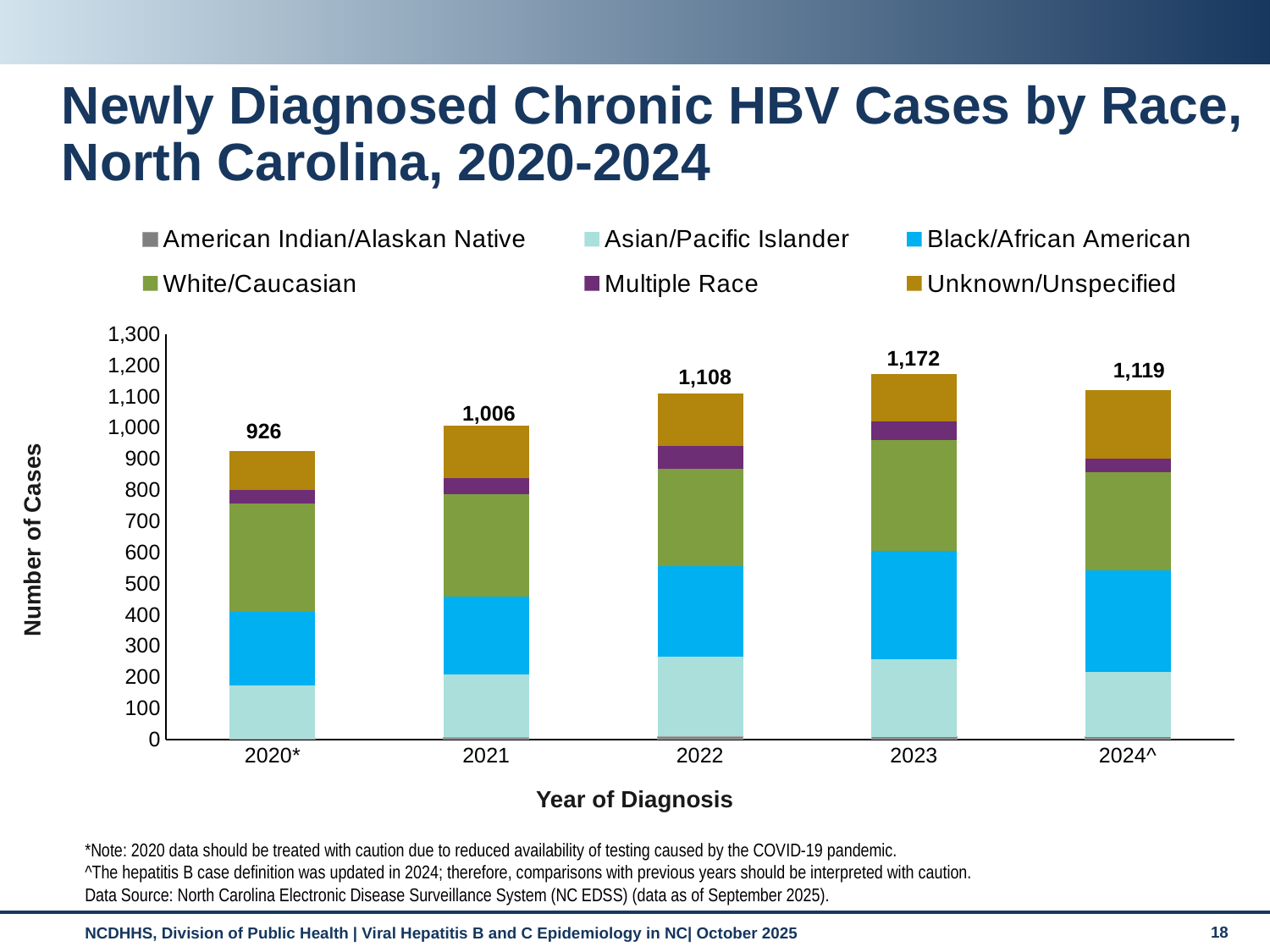
What kind of chart is shown on the slide? Stacked bar chart Which year has the highest total number of cases? 2023 Is the Asian/Pacific Islander value for 2022 greater or less than 200? greater How many race categories does the legend list? 6 How many years are shown on the x axis? 5 What is the total number of cases shown for 2024^? 1,119 What is the total number of newly diagnosed chronic HBV cases shown for 2023? 1,172 What is the difference between the total cases in 2021 and 2020*? 80 What is the total number of cases shown for 2020*? 926 Which year has the lowest total number of cases? 2020* What is the difference between the total cases in 2023 and 2022? 64 Which year has a larger total number of cases, 2022 or 2024^? 2024^